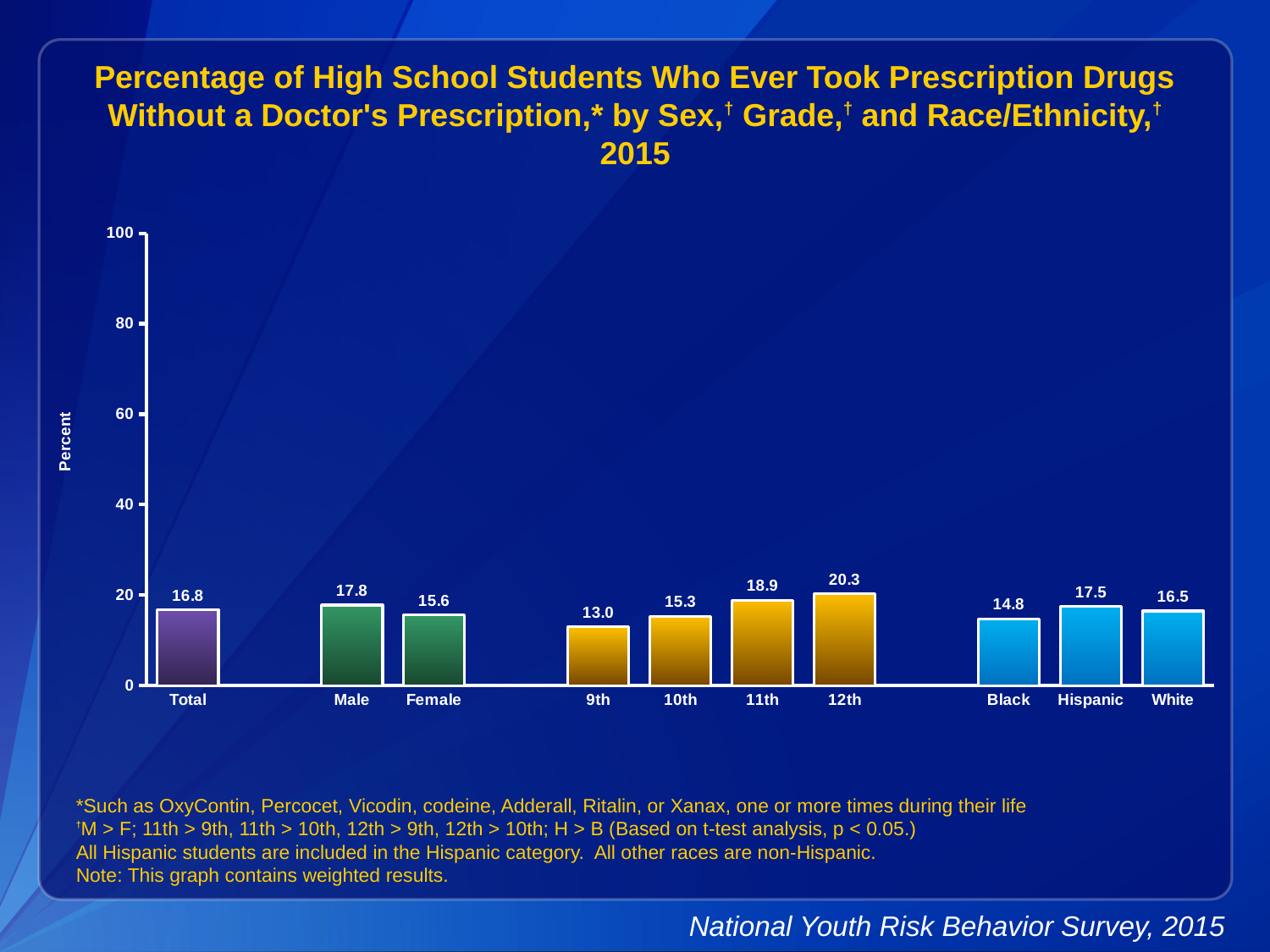
What is the value for 12th grade students? 20.3 What is the label on the y axis? Percent What is the value for Hispanic students? 17.5 Is the value for 11th grade greater or less than 20? less Which category has the highest value? 12th Which is larger, the value for Black or the value for White? White What is the value for Total? 16.8 Which category has the lowest value? 9th What kind of chart is this? bar chart How many bars are shown in the chart? 10 Do the values rise or fall from 9th grade to 12th grade? rise What is the difference between the Male and Female values? 2.2